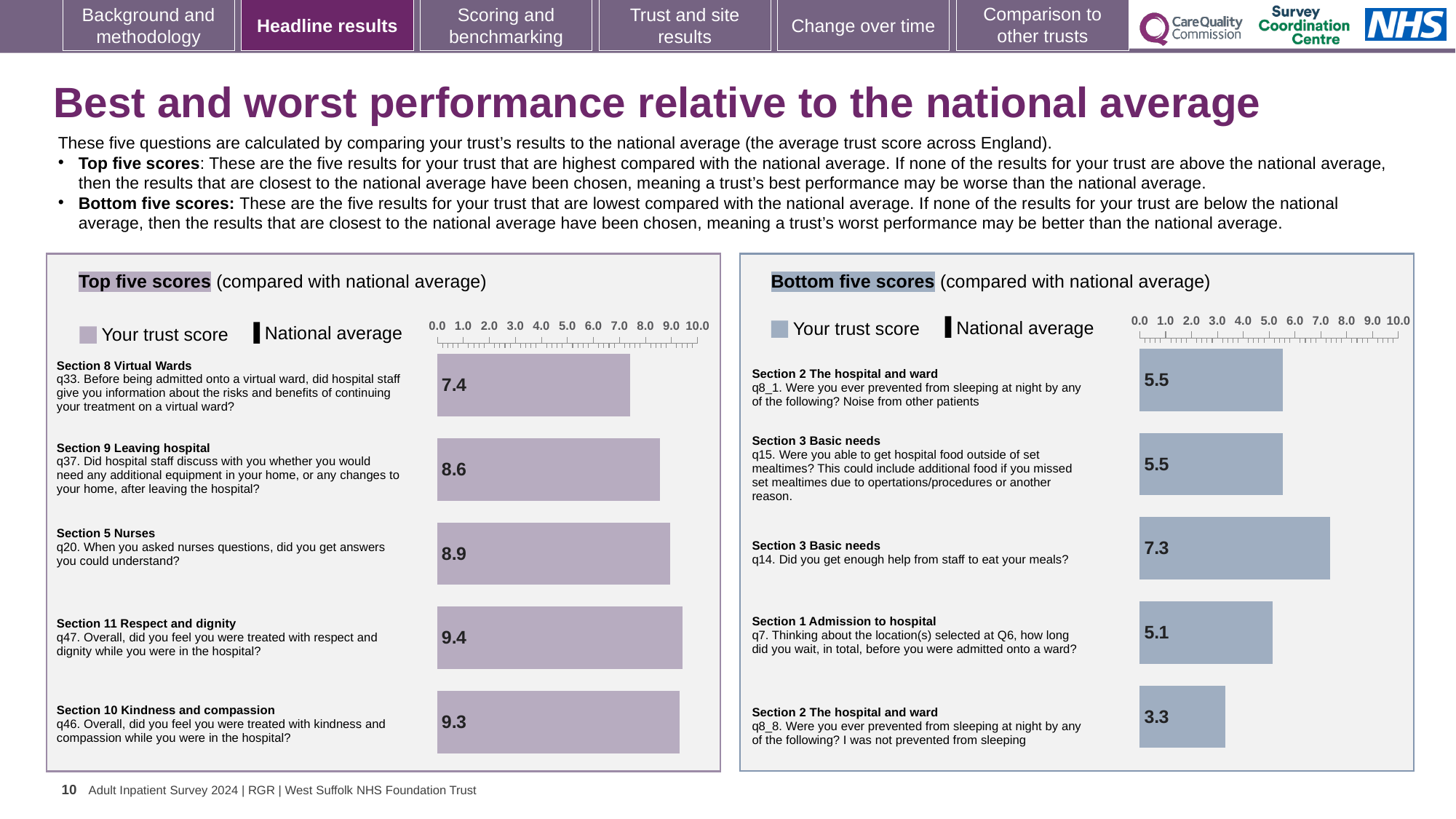
In the Top five scores chart, what is the trust score for q47 (treated with respect and dignity)? 9.4 In the Top five scores chart, which question has the lowest trust score? q33. Before being admitted onto a virtual ward, did hospital staff give you information about the risks and benefits of continuing your treatment on a virtual ward? In the Top five scores chart, which question has the highest trust score? q47. Overall, did you feel you were treated with respect and dignity while you were in the hospital? What type of chart is used in the Top five scores panel? Bar chart In the Bottom five scores chart, which is larger: the trust score for q7 or for q14? q14 In the Bottom five scores chart, what is the difference between the trust scores for q14 and q8_8? 4.0 How many questions are plotted in the Bottom five scores chart? 5 In the Top five scores chart, what is the trust score for q33 (information about virtual ward risks and benefits)? 7.4 In the Bottom five scores chart, what is the trust score for q14 (enough help from staff to eat your meals)? 7.3 In the Bottom five scores chart, what is the trust score for q8_8 (I was not prevented from sleeping)? 3.3 In the Bottom five scores chart, which question has the lowest trust score? q8_8. Were you ever prevented from sleeping at night by any of the following? I was not prevented from sleeping In the Top five scores chart, what is the difference between the trust scores for q20 and q37? 0.3